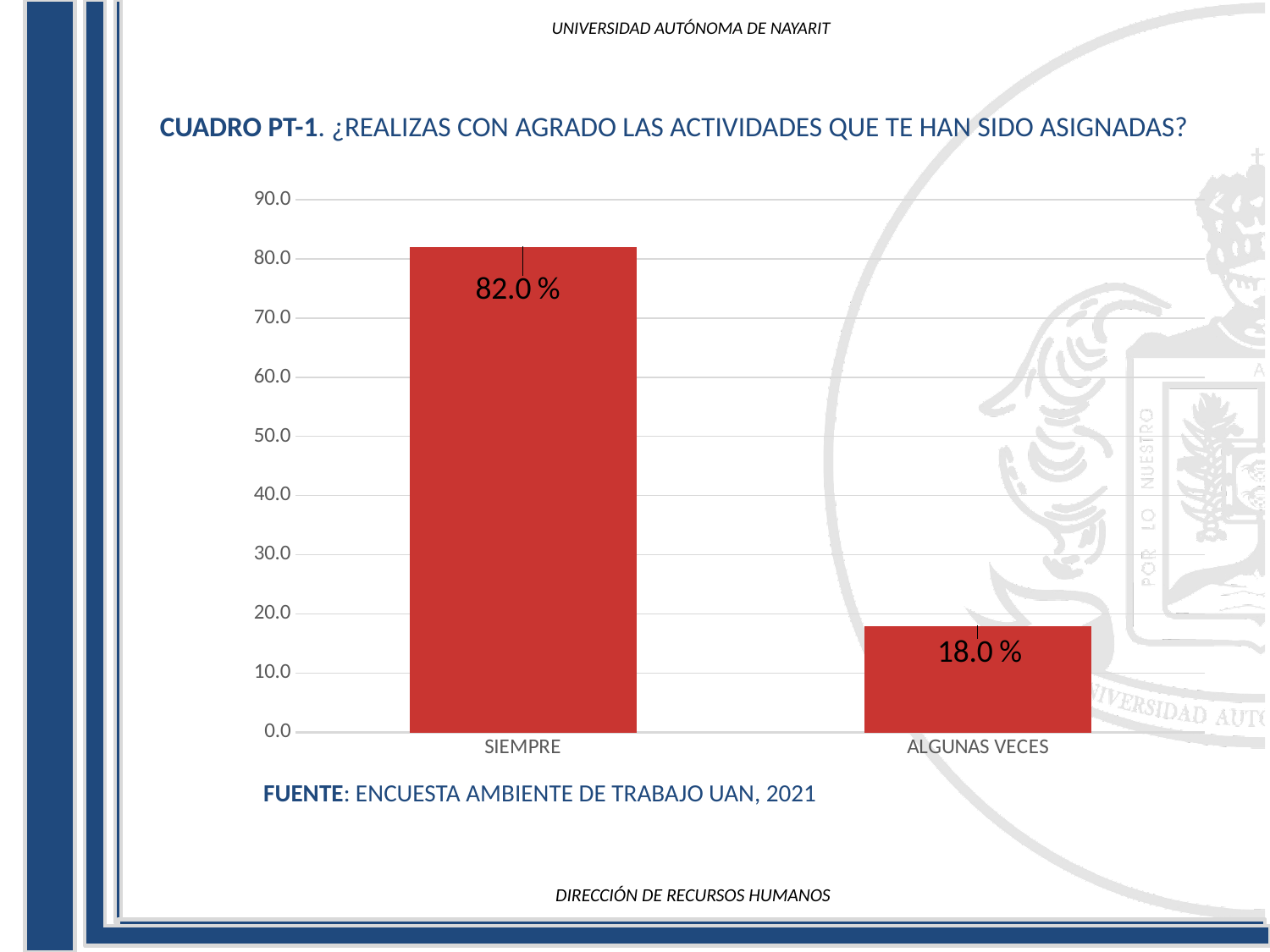
What source is cited below the chart? ENCUESTA AMBIENTE DE TRABAJO UAN, 2021 What is the value for ALGUNAS VECES? 18.0 % What kind of chart is shown on the slide? bar chart Is the value for SIEMPRE greater or less than 80.0? greater How many categories are shown on the x axis? 2 Which category has the highest value? SIEMPRE Which category has the lowest value? ALGUNAS VECES What is the difference between the values for SIEMPRE and ALGUNAS VECES? 64.0 % What is the value for SIEMPRE? 82.0 % What is the highest value shown on the y axis? 90.0 Which is larger, the value for SIEMPRE or the value for ALGUNAS VECES? SIEMPRE Is the value for ALGUNAS VECES greater or less than 20.0? less